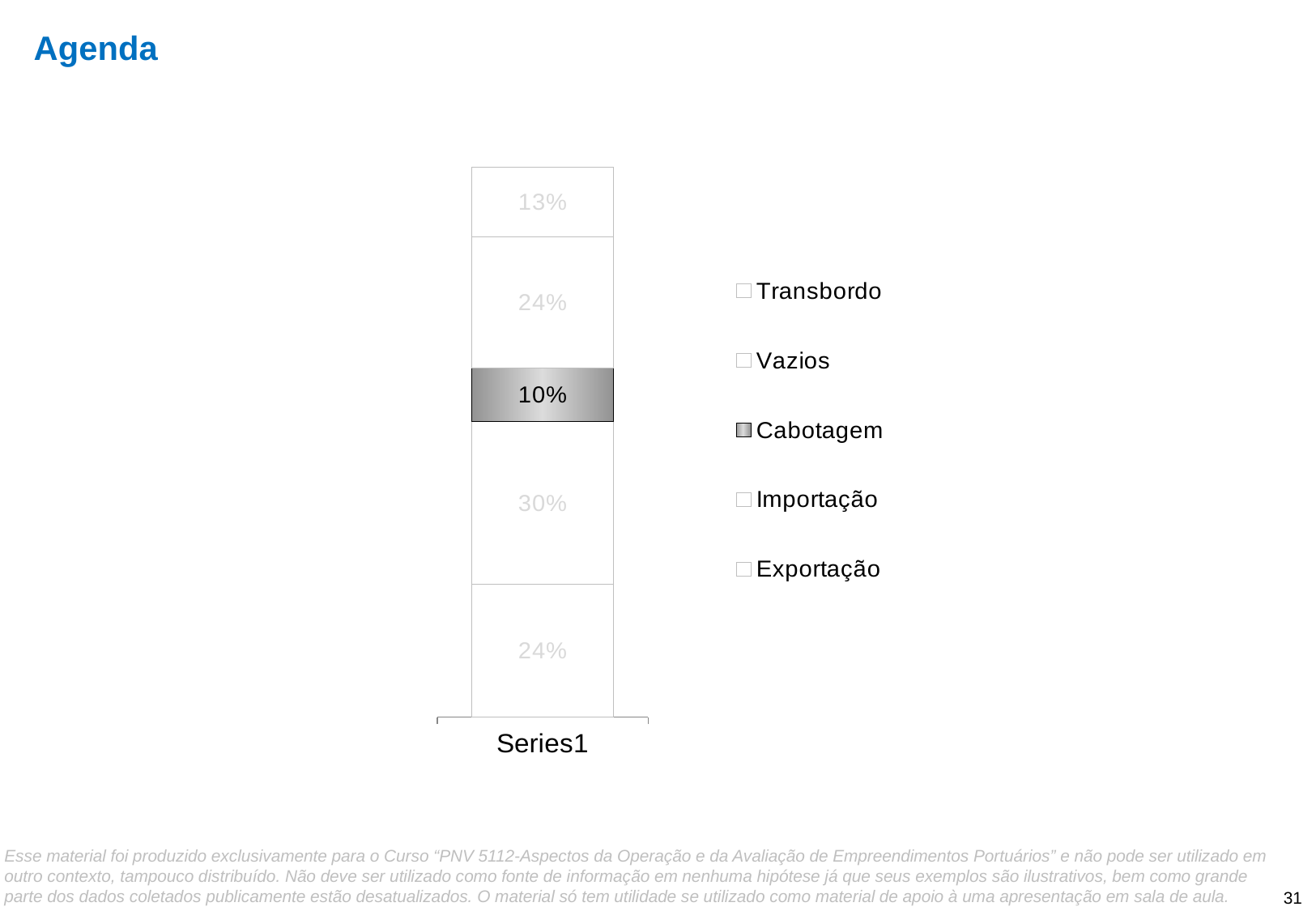
What is the category label shown on the x axis? Series1 Which is larger, the 30% segment or the Cabotagem segment? The 30% segment Which legend entry is shown with a gray (shaded) marker? Cabotagem What value is labelled on the topmost segment of the stacked bar? 13% How many series does the legend list? 5 What is the largest segment value shown in the stacked bar? 30% What is the smallest segment value shown in the stacked bar? 10% What value is labelled on the bottom segment of the stacked bar? 24% How many bars (categories) are plotted on the x axis? 1 What is the difference between the largest segment (30%) and the Cabotagem segment (10%)? 20 percentage points What is the value of the Cabotagem segment of the bar? 10% What kind of chart is shown on the slide? Stacked bar chart